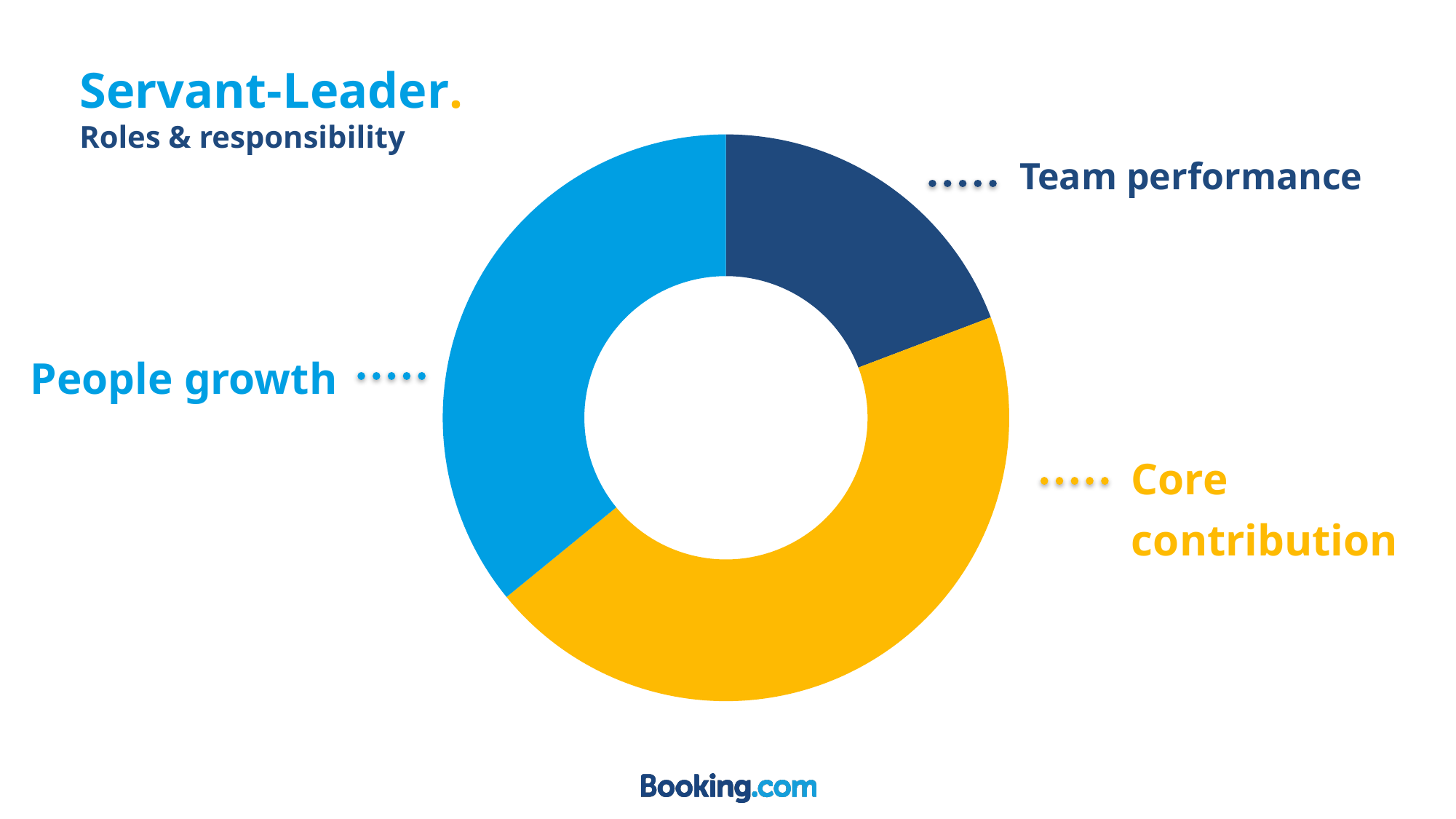
Which segment is the largest in the chart? Core contribution What is the title of the slide containing the chart? Servant-Leader. Roles & responsibility Which segment is the smallest in the chart? Team performance What kind of chart is shown on the slide? Pie chart (donut) How many segments does the chart have? 3 Which segment is larger, People growth or Team performance? People growth What colour is the Core contribution segment? Yellow Which segment is smaller, Team performance or Core contribution? Team performance Which segment is larger, Core contribution or People growth? Core contribution